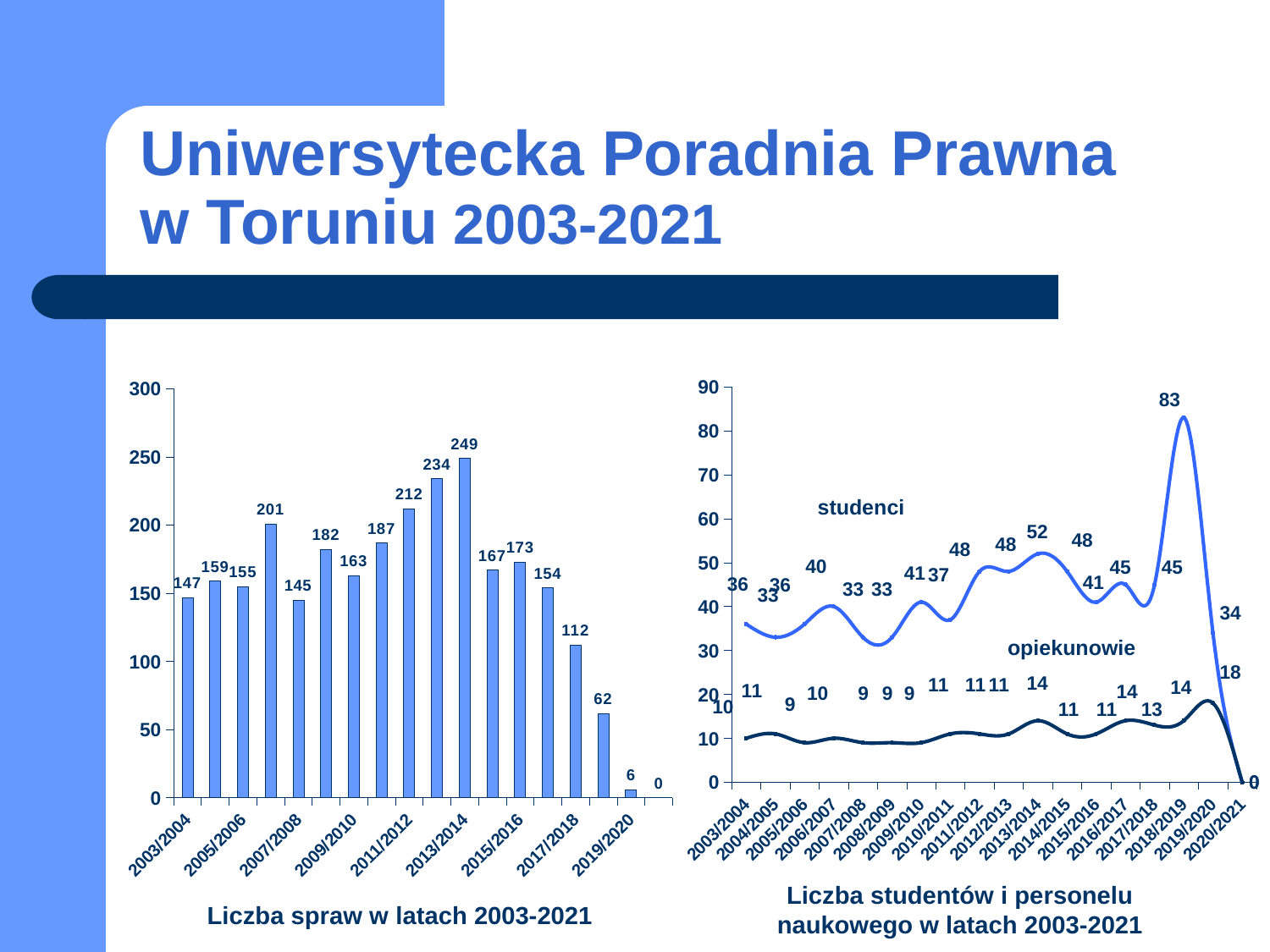
In the right chart 'Liczba studentów i personelu naukowego w latach 2003-2021', in which year does the 'studenci' series reach its highest value? 2018/2019 In the left chart 'Liczba spraw w latach 2003-2021', what is the difference between the values for 2013/2014 and 2011/2012? 37 In the right chart 'Liczba studentów i personelu naukowego w latach 2003-2021', what is the highest value of the 'studenci' series? 83 In the left chart 'Liczba spraw w latach 2003-2021', which year has the highest value? 2013/2014 How many academic years are shown on the x axis of the right chart 'Liczba studentów i personelu naukowego w latach 2003-2021'? 18 In the right chart 'Liczba studentów i personelu naukowego w latach 2003-2021', what is the value of 'opiekunowie' for 2019/2020? 18 In the left chart 'Liczba spraw w latach 2003-2021', what is the value for 2017/2018? 112 What kind of chart is the left chart, 'Liczba spraw w latach 2003-2021'? bar chart In the left chart 'Liczba spraw w latach 2003-2021', which is larger, the value for 2005/2006 or for 2007/2008? 2005/2006 How many series are plotted in the right chart 'Liczba studentów i personelu naukowego w latach 2003-2021'? 2 In the left chart 'Liczba spraw w latach 2003-2021', what is the value for 2013/2014? 249 In the left chart 'Liczba spraw w latach 2003-2021', do the values rise or fall from 2013/2014 to 2019/2020? fall